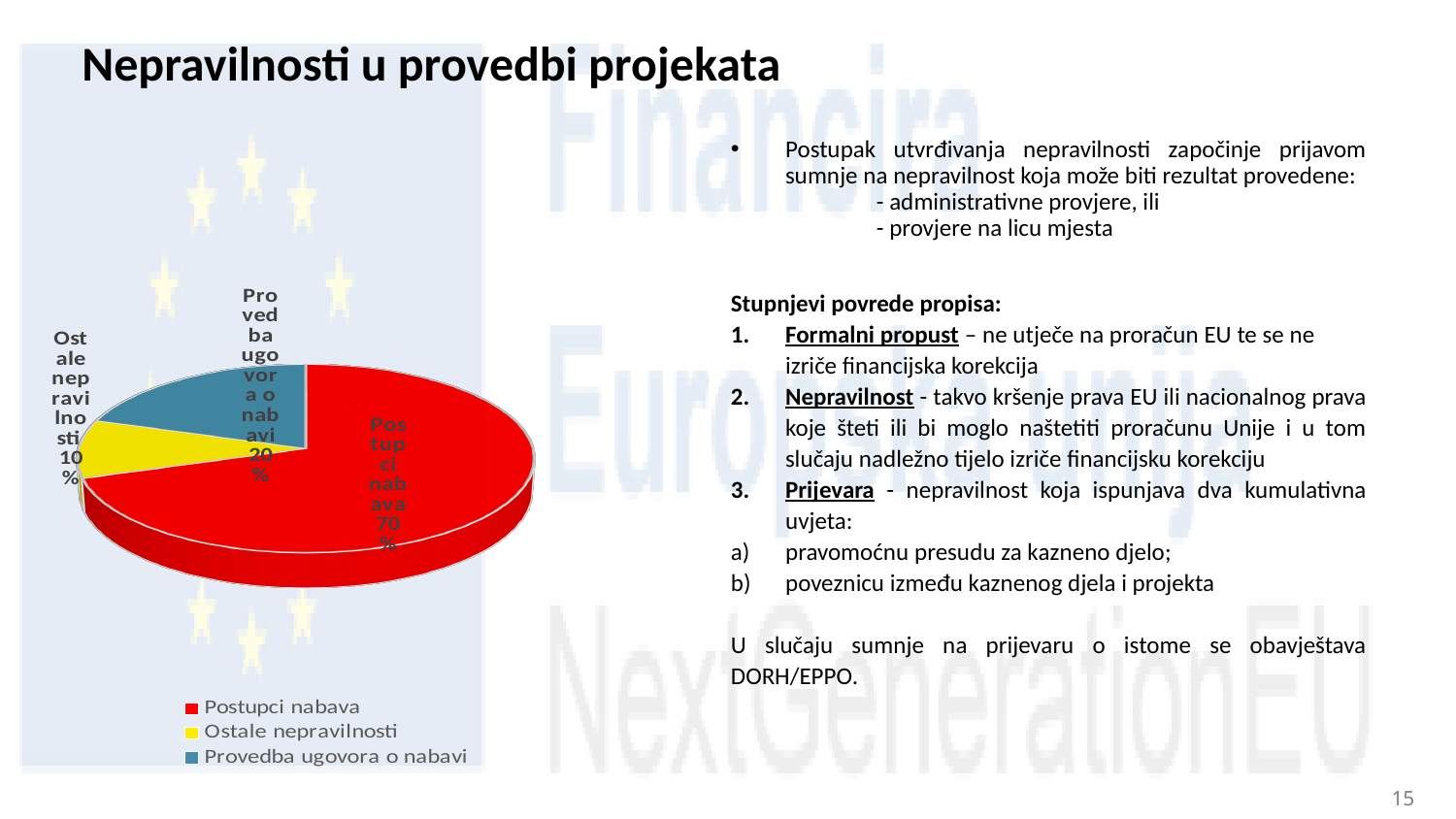
Which is larger, the share for Provedba ugovora o nabavi or the share for Ostale nepravilnosti? Provedba ugovora o nabavi How many slices does the pie chart have? 3 What kind of chart is shown on the slide? pie chart How many entries does the legend list? 3 What share of the pie does Postupci nabava have? 70% What colour is the slice for Ostale nepravilnosti? yellow Which category has the largest slice of the pie? Postupci nabava Which category has the smallest slice of the pie? Ostale nepravilnosti What share of the pie does Ostale nepravilnosti have? 10% What share of the pie does Provedba ugovora o nabavi have? 20% What colour is the slice for Postupci nabava? red What is the difference in percentage points between Postupci nabava and Provedba ugovora o nabavi? 50